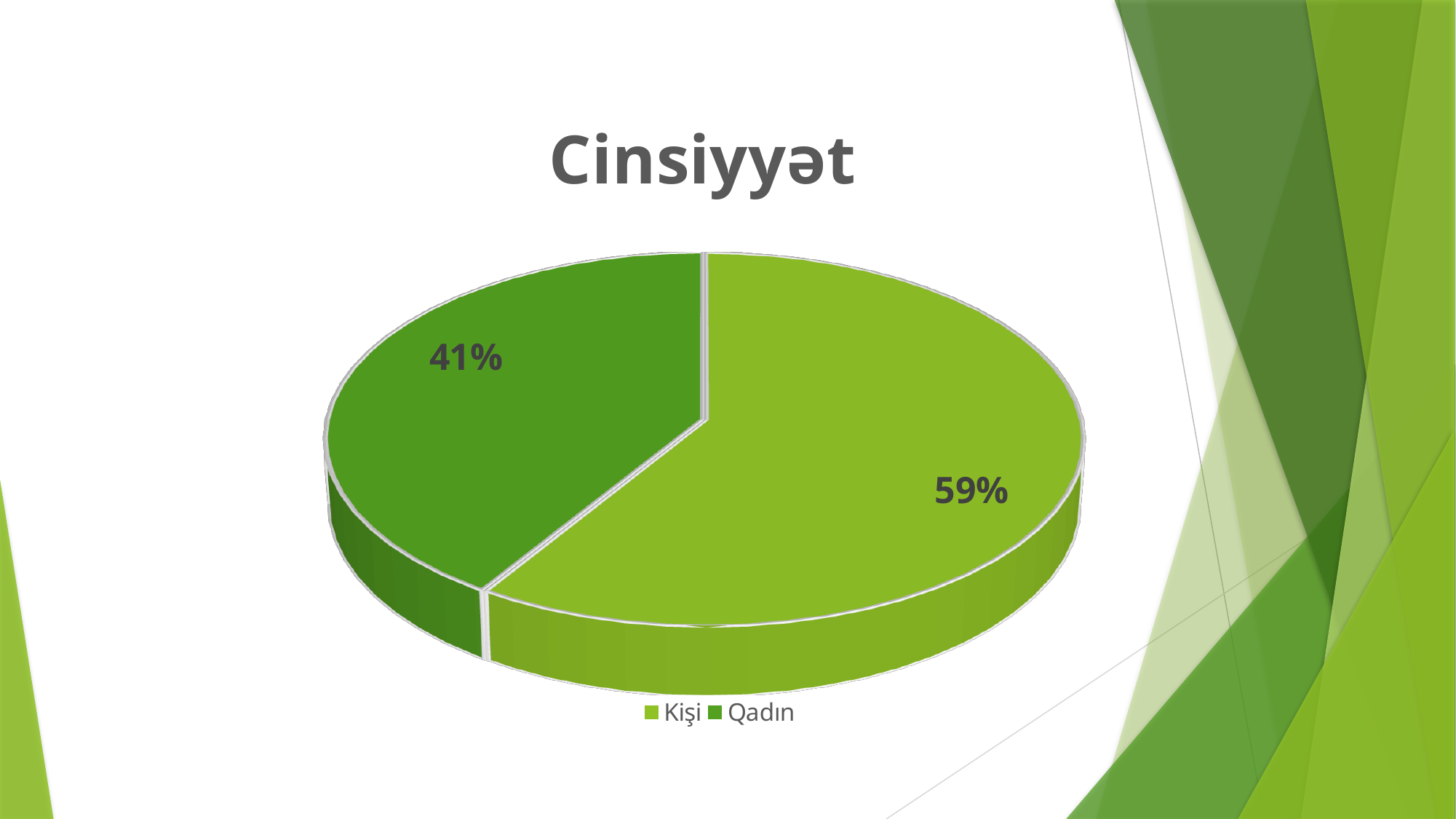
What is the title of the chart? Cinsiyyət Which category has the largest share of the pie? Kişi What percentage of the pie is Kişi? 59% Which category has the smallest share of the pie? Qadın Which legend entry is shown in the lighter green colour? Kişi What is the difference in percentage points between Kişi and Qadın? 18 How many entries does the legend list? 2 What is the share of the pie taken by the Qadın slice? 41% What kind of chart is shown on the slide? pie chart Which is larger, the share for Kişi or the share for Qadın? Kişi What percentage of the pie is Qadın? 41% How many slices does the pie chart have? 2